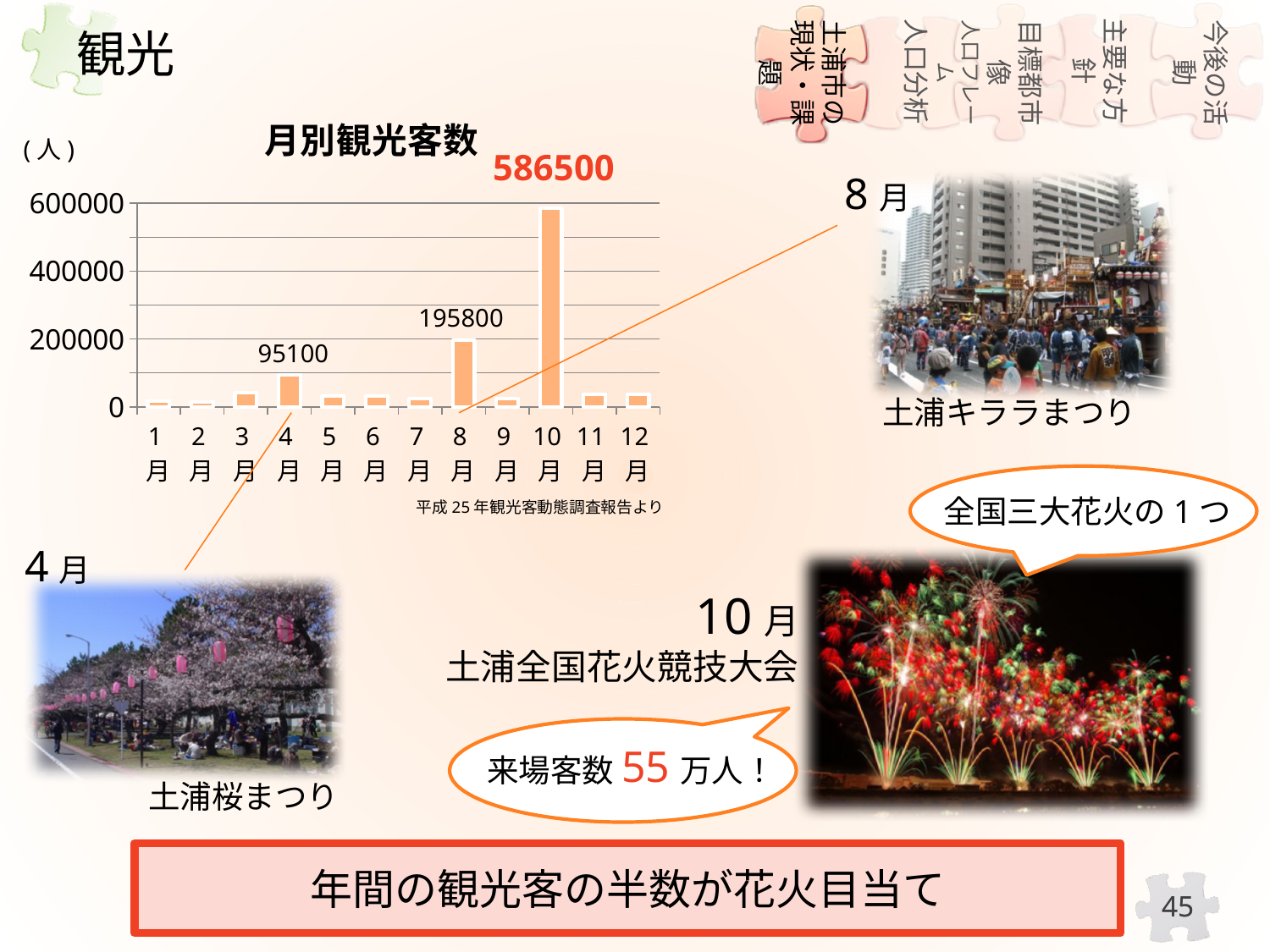
What is the value for 10月 in the 月別観光客数 chart? 586500 What is the difference between the values for 10月 and 8月 in the 月別観光客数 chart? 390700 What is the value for 4月 in the 月別観光客数 chart? 95100 Which month has the highest number of tourists in the 月別観光客数 chart? 10月 What is the value for 8月 in the 月別観光客数 chart? 195800 Is the value for 10月 in the 月別観光客数 chart greater or less than 400000? greater What kind of chart is the 月別観光客数 chart? bar chart Which is larger in the 月別観光客数 chart, the value for 8月 or the value for 4月? 8月 How many months are shown on the x axis of the 月別観光客数 chart? 12 Is the value for 3月 in the 月別観光客数 chart greater or less than 200000? less What is the difference between the values for 8月 and 4月 in the 月別観光客数 chart? 100700 What unit is shown at the top of the y axis of the 月別観光客数 chart? 人